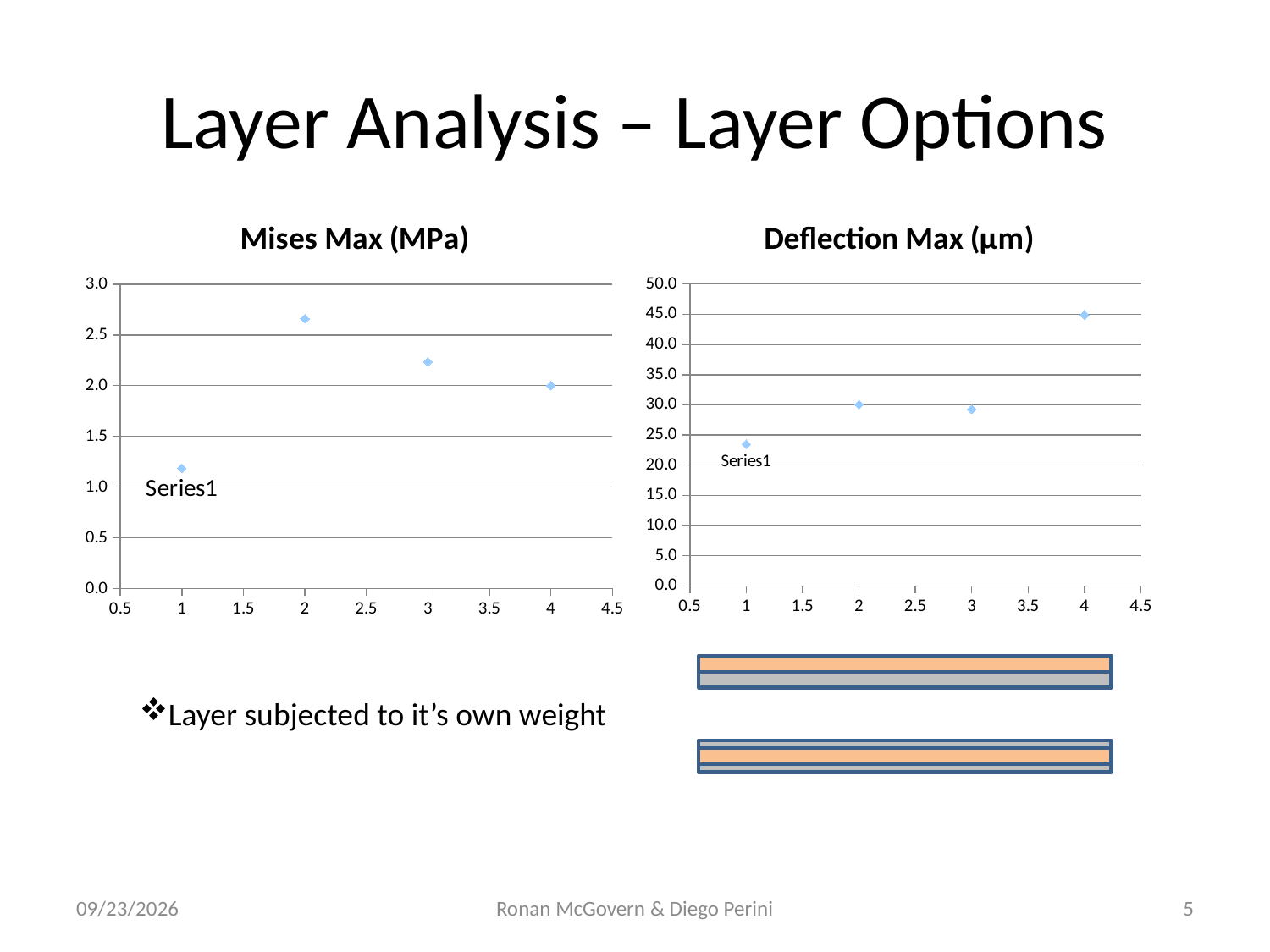
How many data points are plotted in the Mises Max (MPa) chart? 4 In the Mises Max (MPa) chart, which is larger, the value at x = 3 or the value at x = 4? x = 3 In the Mises Max (MPa) chart, is the value at x = 1 greater or less than 1.5? less In the Deflection Max (μm) chart, at which x value is the plotted value lowest? 1 In the Deflection Max (μm) chart, is the value at x = 4 greater or less than 40.0? greater What kind of chart is the Mises Max (MPa) chart? scatter chart What is the title of the chart on the right of the slide? Deflection Max (μm) In the Deflection Max (μm) chart, at which x value is the plotted value highest? 4 How many data points are plotted in the Deflection Max (μm) chart? 4 In the Mises Max (MPa) chart, at which x value is the plotted value highest? 2 In the Mises Max (MPa) chart, is the value at x = 2 greater or less than 2.5? greater In the Mises Max (MPa) chart, at which x value is the plotted value lowest? 1